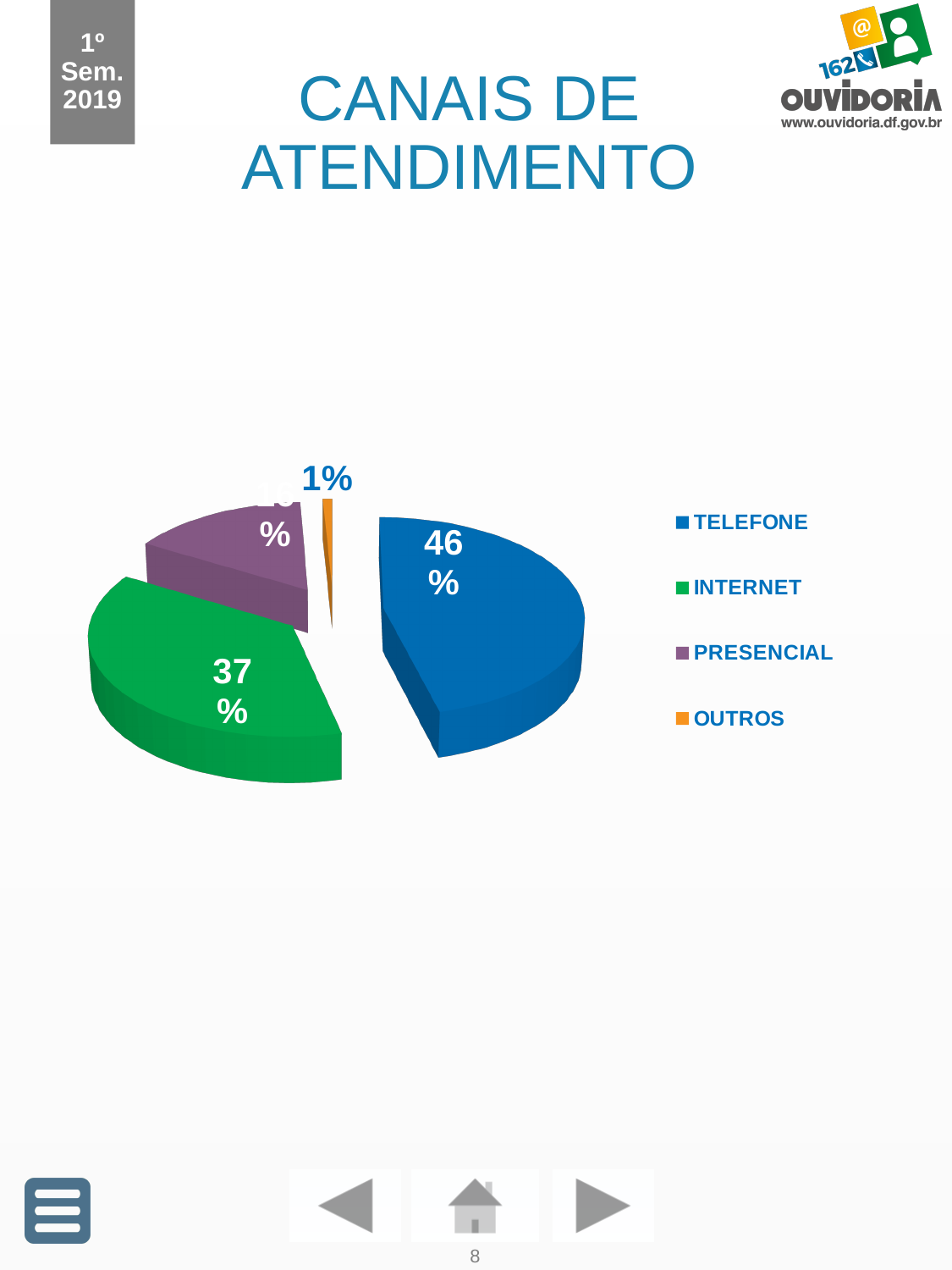
What is the difference in percentage points between TELEFONE and INTERNET? 9 What is the title of the slide containing the pie chart? CANAIS DE ATENDIMENTO Which channel has the largest share of the pie chart? TELEFONE What percentage of the pie chart is INTERNET? 37% Which channel has the smallest share of the pie chart? OUTROS How many categories does the legend of the pie chart list? 4 What kind of chart is shown on the slide? pie chart Which is larger, the share for INTERNET or the share for PRESENCIAL? INTERNET What colour represents INTERNET in the pie chart? green What percentage of the pie chart is TELEFONE? 46% Which is larger, the share for TELEFONE or the share for OUTROS? TELEFONE What percentage of the pie chart is OUTROS? 1%